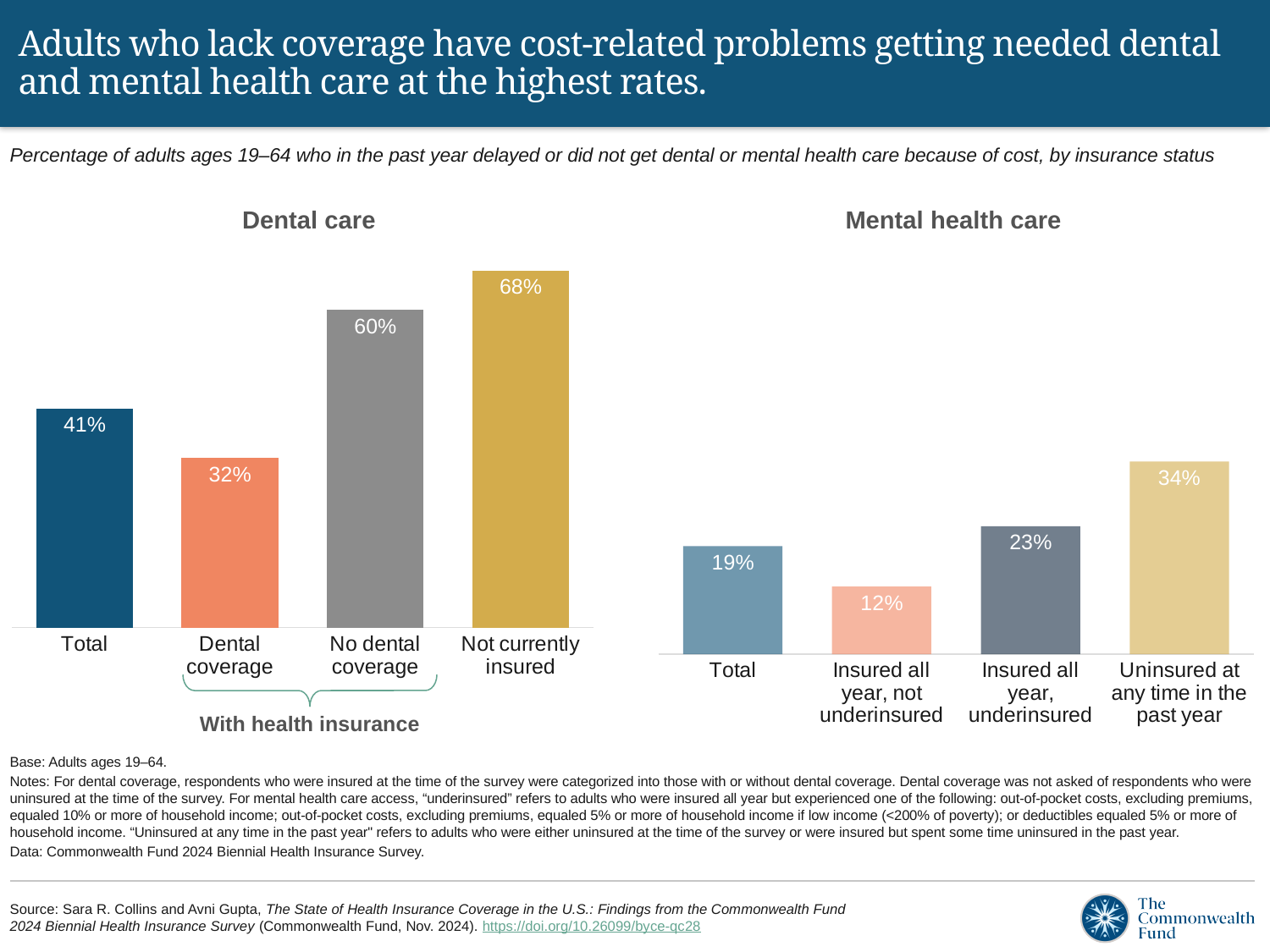
In the Mental health care chart, what is the value for Total? 19% In the Mental health care chart, what is the value for Insured all year, underinsured? 23% In the Dental care chart, what is the value for Not currently insured? 68% In the Dental care chart, what is the difference between No dental coverage and Dental coverage? 28 percentage points How many categories are shown in the Mental health care chart? 4 In the Mental health care chart, which category has the lowest value? Insured all year, not underinsured In the Dental care chart, which category has the highest value? Not currently insured In the Dental care chart, which is larger: Total or Dental coverage? Total What type of chart is the Dental care chart? Bar chart In the Mental health care chart, what is the difference between Uninsured at any time in the past year and Total? 15 percentage points In the Dental care chart, which categories are grouped under the bracket labeled 'With health insurance'? Dental coverage and No dental coverage In the Dental care chart, what is the value for Dental coverage? 32%